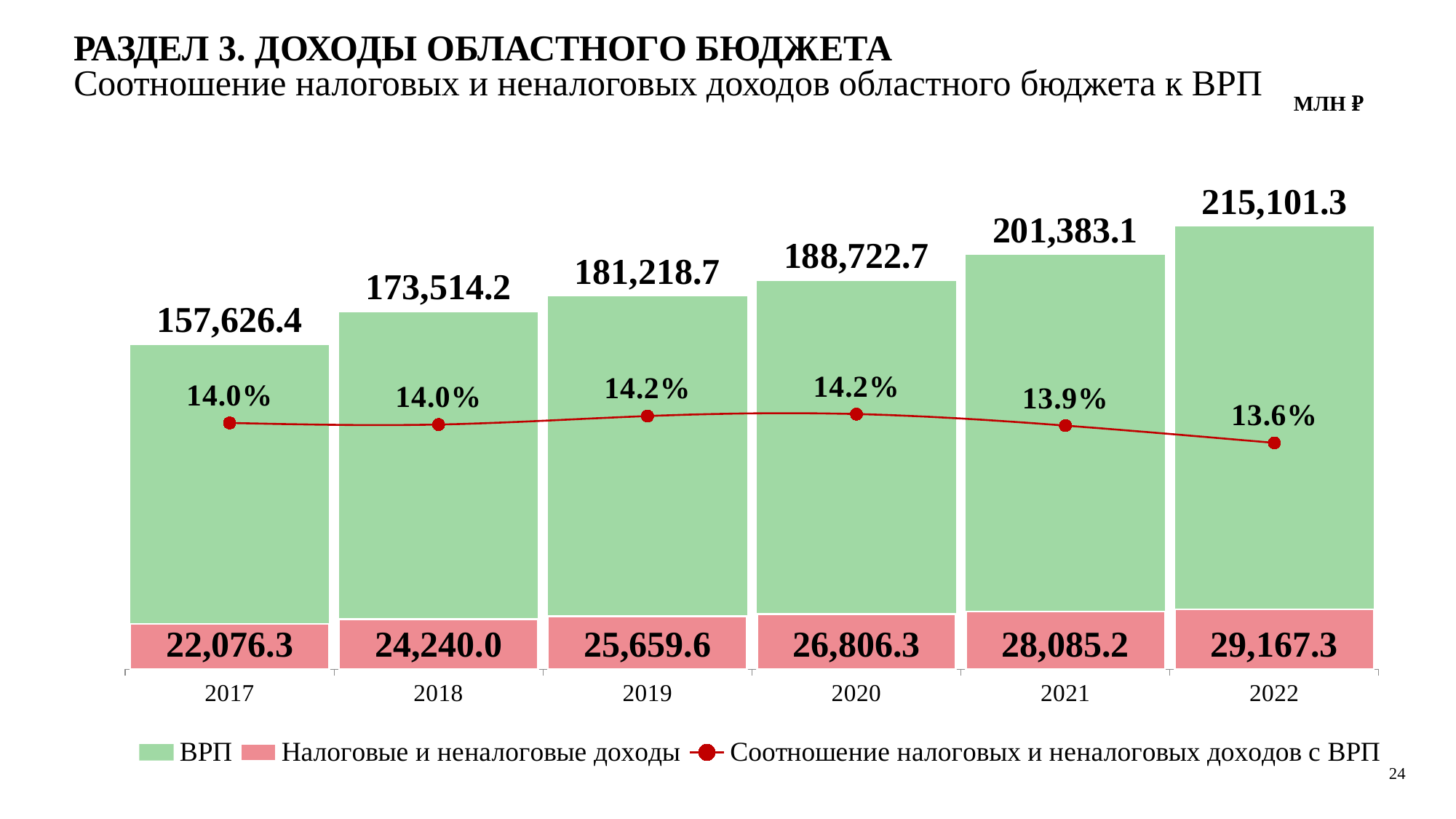
In which year are Налоговые и неналоговые доходы the lowest? 2017 How many years are shown on the x axis? 6 What is the value of ВРП for 2019? 181,218.7 What is the value of Соотношение налоговых и неналоговых доходов с ВРП for 2022? 13.6% Does ВРП rise or fall from 2017 to 2022? rise What is the value of Налоговые и неналоговые доходы for 2021? 28,085.2 Which year has a higher Соотношение налоговых и неналоговых доходов с ВРП, 2019 or 2021? 2019 What is the difference between ВРП in 2022 and ВРП in 2017? 57,474.9 How many series does the legend list? 3 By how much did Налоговые и неналоговые доходы increase from 2021 to 2022? 1,082.1 In which year is ВРП the highest? 2022 In which year is Соотношение налоговых и неналоговых доходов с ВРП the lowest? 2022